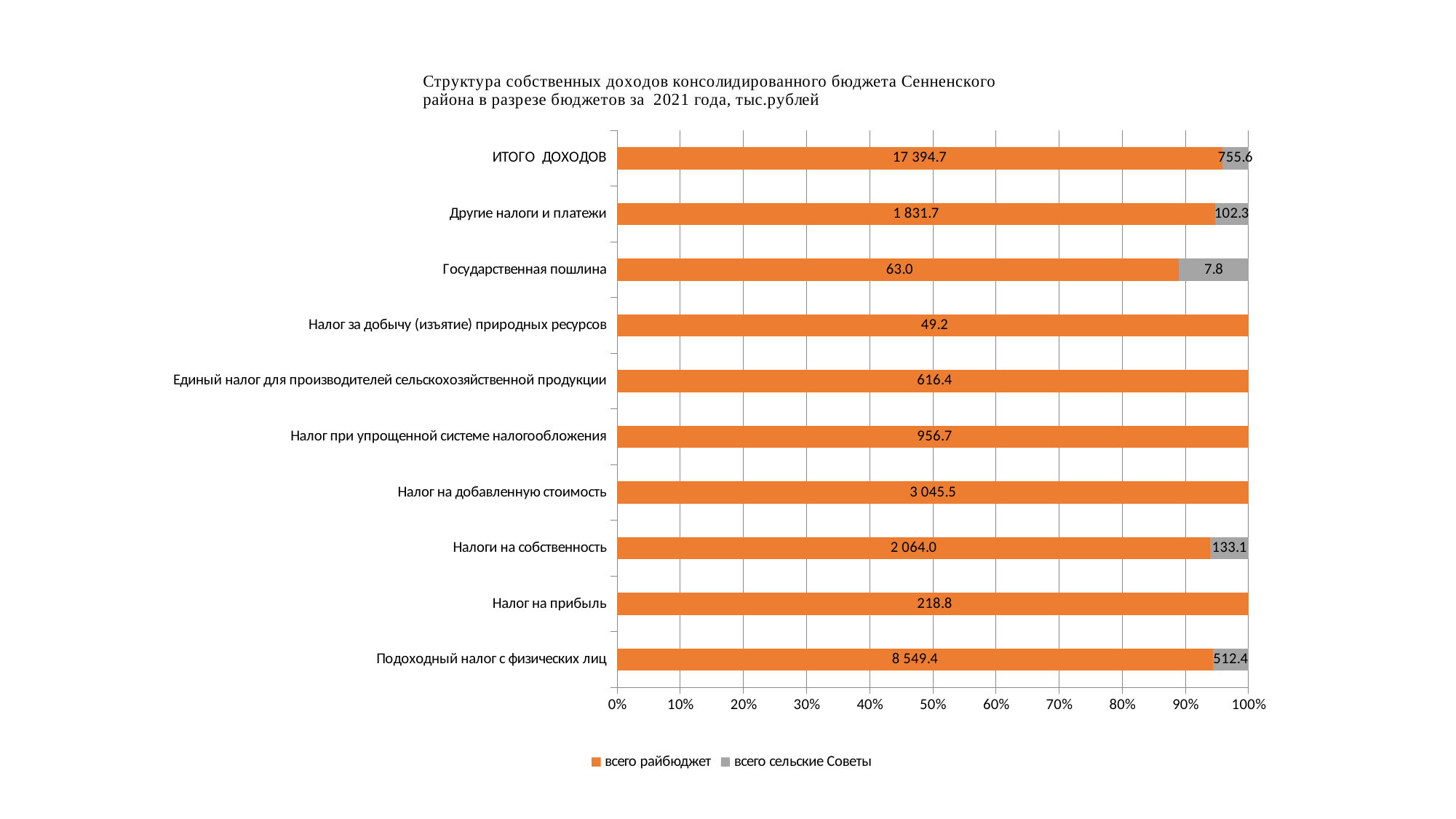
What is the total of the two series for Государственная пошлина? 70.8 Which category has the lowest value for всего райбюджет? Налог за добычу (изъятие) природных ресурсов What is the value of всего райбюджет for Налог на добавленную стоимость? 3 045.5 Which is larger for всего райбюджет: Налог на добавленную стоимость or Налоги на собственность? Налог на добавленную стоимость Excluding ИТОГО ДОХОДОВ, which category has the highest value for всего райбюджет? Подоходный налог с физических лиц What is the value of всего райбюджет for ИТОГО ДОХОДОВ? 17 394.7 How many categories are plotted on the vertical axis? 10 How many series does the legend list? 2 What is the difference between всего райбюджет and всего сельские Советы for Подоходный налог с физических лиц? 8 037.0 What kind of chart is shown on the slide? Stacked bar chart What is the value of всего сельские Советы for ИТОГО ДОХОДОВ? 755.6 What is the value of всего сельские Советы for Налоги на собственность? 133.1